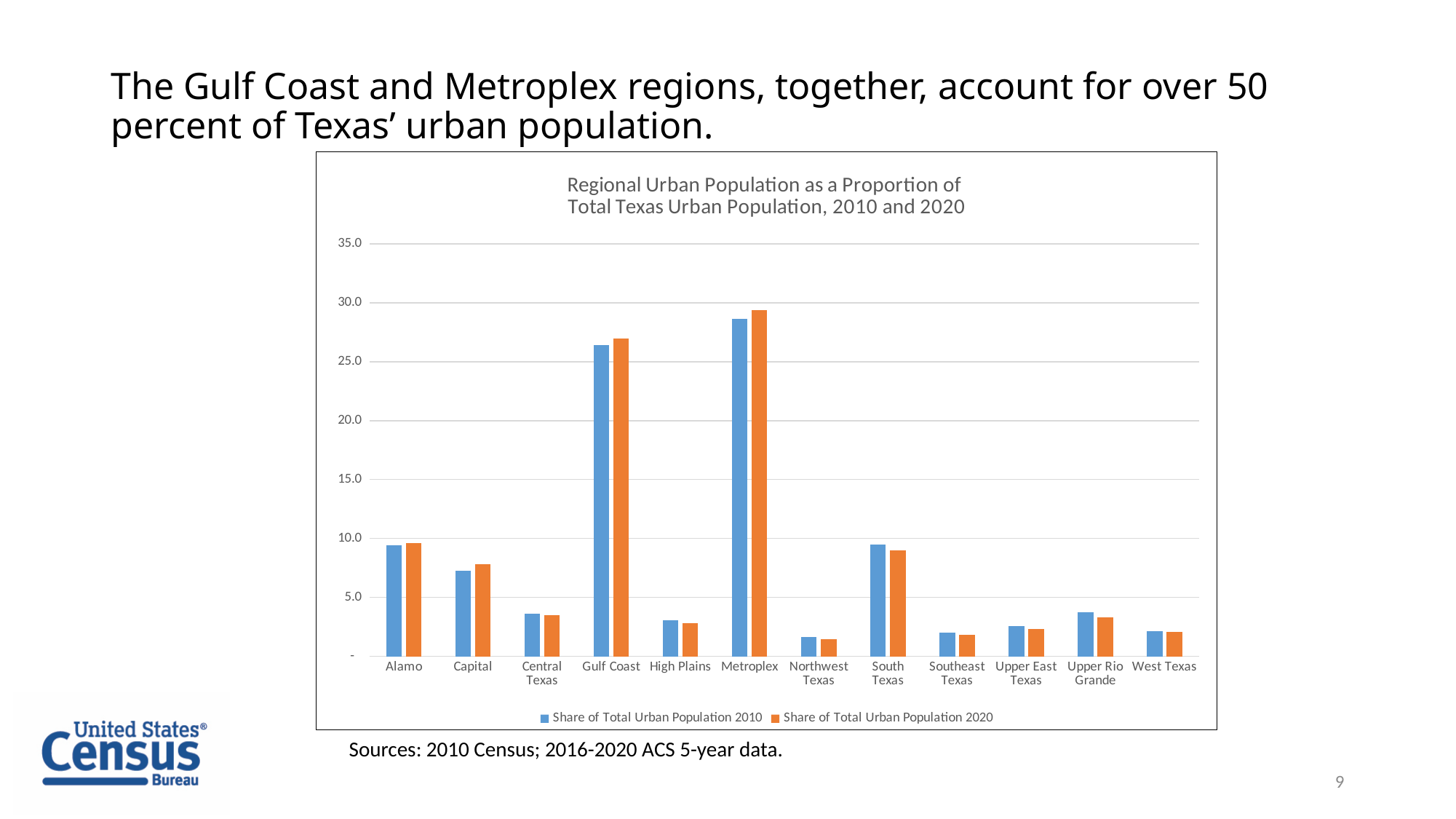
How many regions are shown on the x axis of the chart? 12 How many series does the chart's legend list? 2 Which is larger, the 2010 share for Alamo or the 2010 share for Capital? Alamo What kind of chart is shown on the slide? bar chart Is the Share of Total Urban Population 2010 for Gulf Coast greater or less than 25.0? greater Is the Share of Total Urban Population 2010 for Capital greater or less than 5.0? greater Which region has the highest share of total urban population in 2010? Metroplex What is the title of the chart? Regional Urban Population as a Proportion of Total Texas Urban Population, 2010 and 2020 Is the Share of Total Urban Population 2020 for Metroplex greater or less than 30.0? less Which region has the highest share of total urban population in 2020? Metroplex Which is larger, the 2020 share for Gulf Coast or the 2020 share for Metroplex? Metroplex